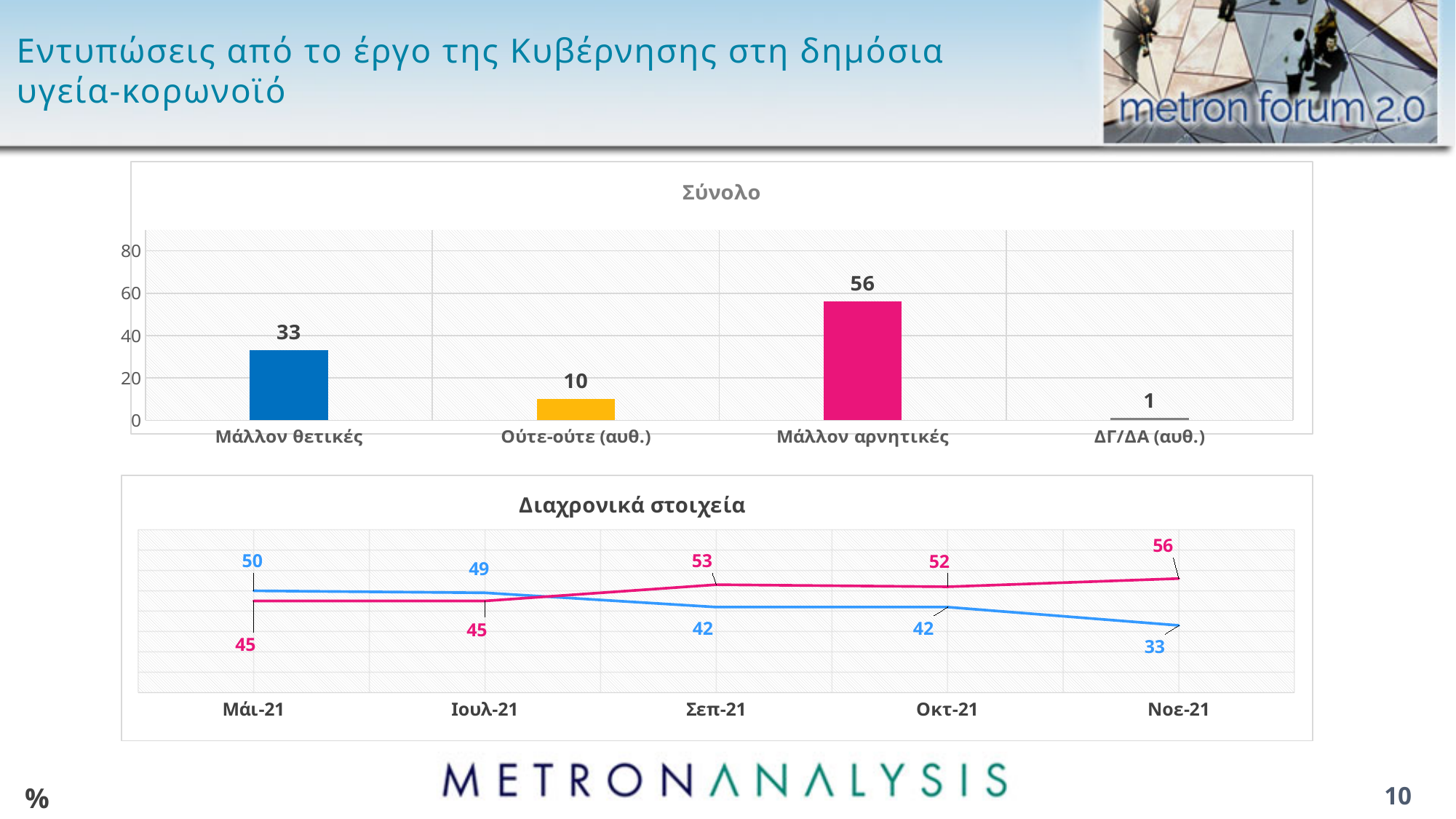
In the 'Διαχρονικά στοιχεία' chart, which is larger at Ιουλ-21: the blue line or the pink line? The blue line In the 'Διαχρονικά στοιχεία' chart, what is the value of the pink line at Σεπ-21? 53 In the 'Σύνολο' chart, how many categories are shown? 4 In the 'Σύνολο' chart, what is the value for 'Μάλλον αρνητικές'? 56 In the 'Διαχρονικά στοιχεία' chart, how many time points are shown on the x axis? 5 In the 'Σύνολο' chart, what is the difference between 'Μάλλον αρνητικές' and 'Μάλλον θετικές'? 23 In the 'Διαχρονικά στοιχεία' chart, does the blue line rise or fall from Μάι-21 to Νοε-21? Fall In the 'Σύνολο' chart, what is the value for 'Ούτε-ούτε (αυθ.)'? 10 In the 'Διαχρονικά στοιχεία' chart, what is the value of the blue line at Νοε-21? 33 In the 'Σύνολο' chart, which category has the lowest value? ΔΓ/ΔΑ (αυθ.) What kind of chart is the 'Σύνολο' chart? Bar chart In the 'Σύνολο' chart, which category has the highest value? Μάλλον αρνητικές